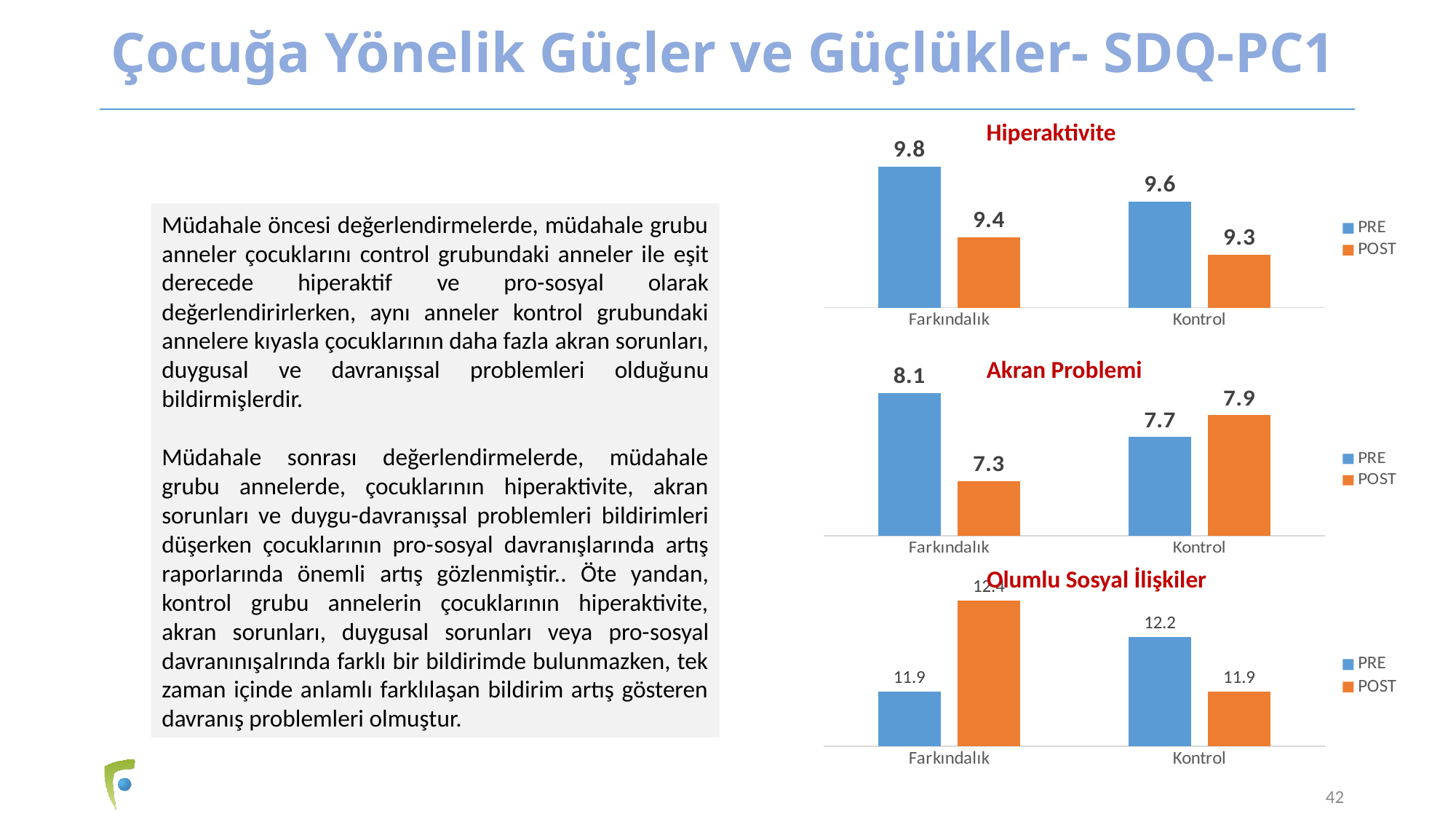
In the Hiperaktivite chart, what is the PRE value for Farkındalık? 9.8 In the Akran Problemi chart, which bar is the highest? Farkındalık PRE In the Akran Problemi chart, what is the difference between the PRE and POST values for Farkındalık? 0.8 In the Akran Problemi chart, what is the POST value for Farkındalık? 7.3 In the Hiperaktivite chart, what is the POST value for Kontrol? 9.3 How many series does the legend of the Hiperaktivite chart list? 2 What type of chart is the Akran Problemi chart? Bar chart In the Hiperaktivite chart, what is the difference between the PRE and POST values for Farkındalık? 0.4 In the Olumlu Sosyal İlişkiler chart, what is the POST value for Kontrol? 11.9 In the Akran Problemi chart, is the PRE or POST value larger for Kontrol? POST In the Olumlu Sosyal İlişkiler chart, what is the PRE value for Kontrol? 12.2 In the Olumlu Sosyal İlişkiler chart, is the PRE or POST value larger for Farkındalık? POST